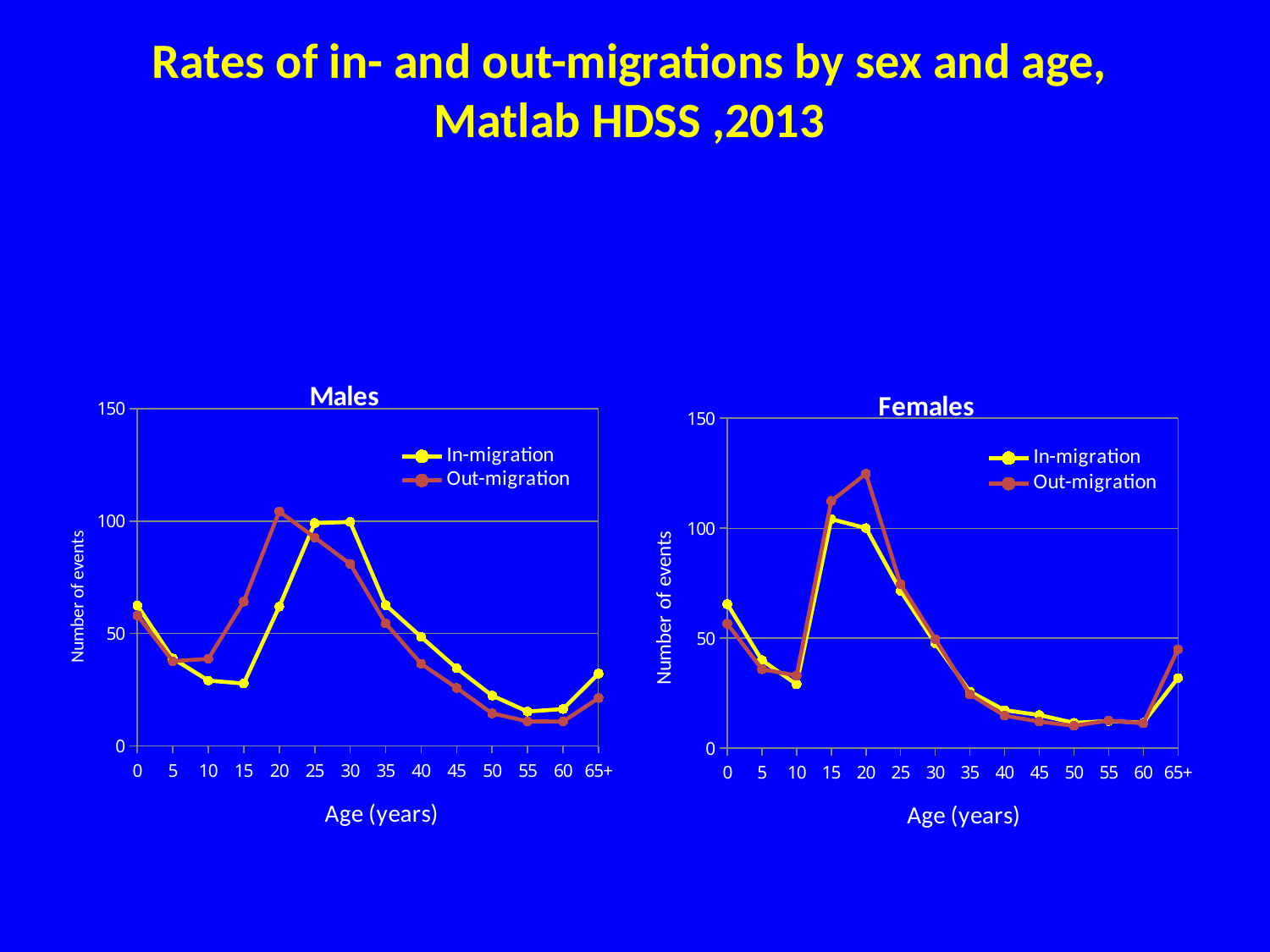
How many series does the legend of the Females chart list? 2 What type of chart is the Males chart? line chart In the Females chart, is the Out-migration value at age 20 greater or less than 100? greater In the Males chart, at age 30, which series has the larger value, In-migration or Out-migration? In-migration In the Females chart, at which age does Out-migration reach its highest value? 20 In the Males chart, is the In-migration value at age 0 greater or less than 50? greater In the Males chart, is the In-migration value at age 10 greater or less than 50? less In the Females chart, does the Out-migration line rise or fall between ages 20 and 50? fall In the Males chart, at age 20, which series has the larger value, In-migration or Out-migration? Out-migration How many age categories are shown on the x axis of the Males chart? 14 In the Males chart, at which age does Out-migration reach its highest value? 20